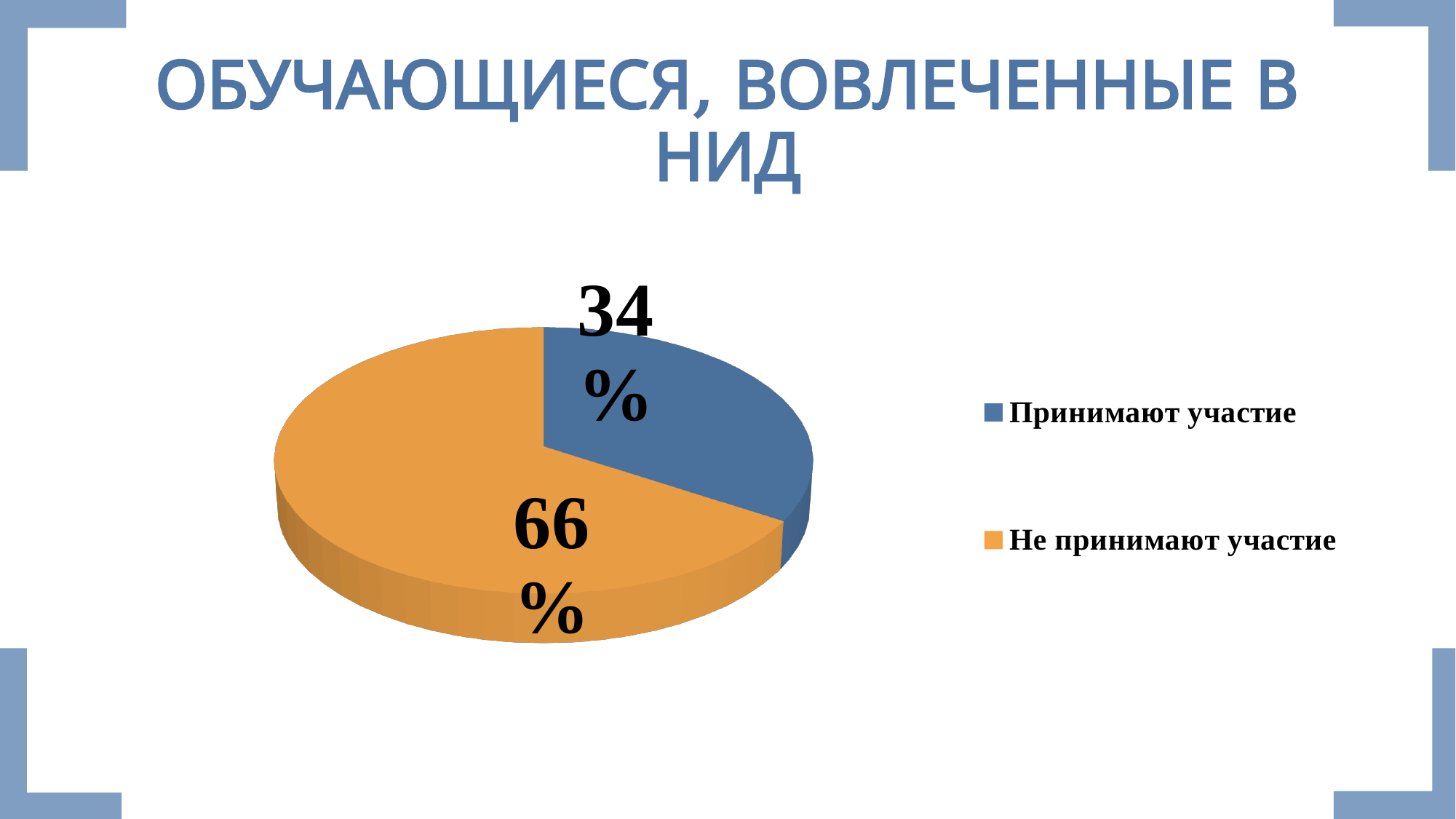
Which category has the largest slice of the pie? Не принимают участие What share of the pie does "Не принимают участие" represent? 66% How many slices does the pie chart have? 2 What kind of chart is shown on the slide? Pie chart What is the difference in percentage points between "Не принимают участие" and "Принимают участие"? 32 What colour is the slice for "Принимают участие"? Blue What is the title of the slide? ОБУЧАЮЩИЕСЯ, ВОВЛЕЧЕННЫЕ В НИД Which category has the smallest slice of the pie? Принимают участие How many entries does the legend list? 2 Which is larger: the slice for "Принимают участие" or the slice for "Не принимают участие"? Не принимают участие What share of the pie does "Принимают участие" represent? 34%